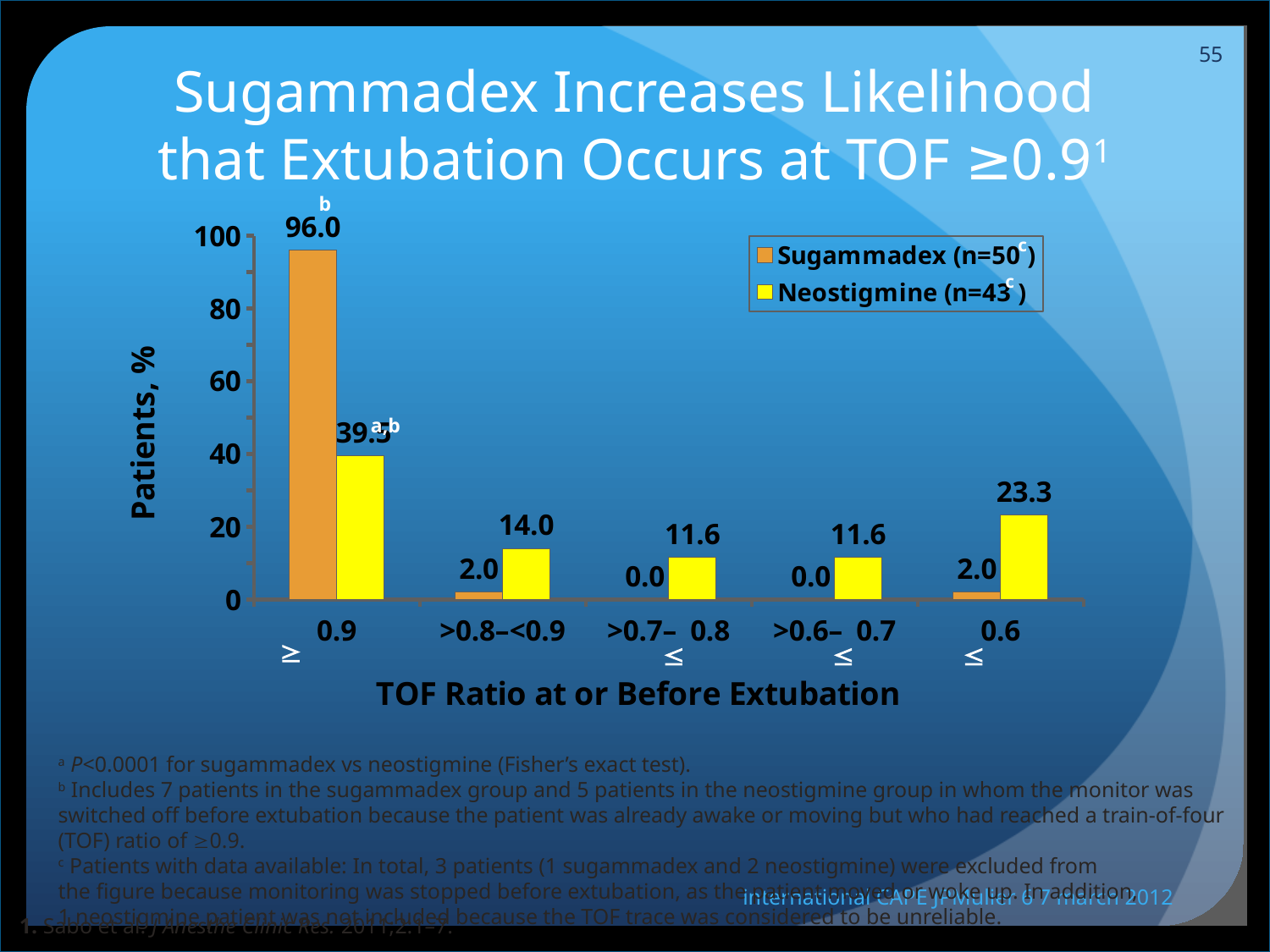
What is the value for Neostigmine in the >0.8–<0.9 category? 14.0 Which TOF ratio category has the highest value for the Neostigmine series? ≥0.9 In the >0.6–≤0.7 category, which series has the larger value, Sugammadex or Neostigmine? Neostigmine How many series does the legend list? 2 What is the value for Sugammadex in the >0.7–≤0.8 category? 0.0 What is the label of the y axis? Patients, % What type of chart is shown on the slide? bar chart What percentage of Sugammadex patients were extubated at a TOF ratio of ≥0.9? 96.0 How many TOF ratio categories are shown on the x axis? 5 What is the difference between the Neostigmine and Sugammadex values in the ≤0.6 category? 21.3 What percentage of Neostigmine patients were extubated at a TOF ratio of ≤0.6? 23.3 Is the Sugammadex value for the ≥0.9 category greater or less than 80? greater